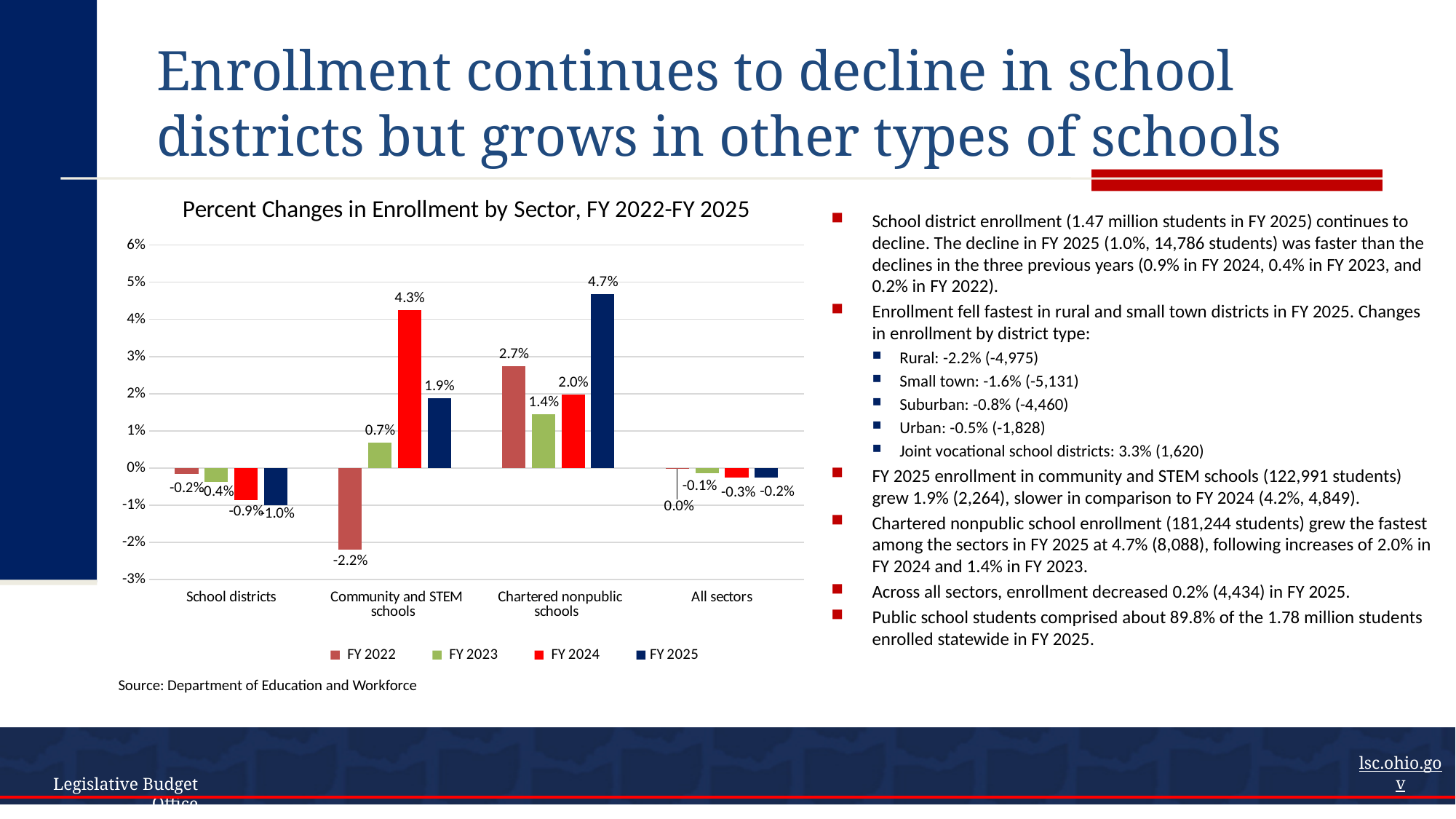
How many categories are shown on the x axis? 4 Which category has the highest FY 2025 value? Chartered nonpublic schools Which category has the lowest FY 2022 value? Community and STEM schools What is the FY 2024 value for Community and STEM schools? 4.3% What is the FY 2025 value for Chartered nonpublic schools? 4.7% What is the FY 2022 value for Community and STEM schools? -2.2% What is the FY 2025 value for School districts? -1.0% What is the difference between the FY 2025 and FY 2024 values for Chartered nonpublic schools? 2.7% Which is larger for Community and STEM schools: the FY 2024 value or the FY 2025 value? FY 2024 What kind of chart is shown? Bar chart How many series does the legend list? 4 What is the title of the chart? Percent Changes in Enrollment by Sector, FY 2022-FY 2025